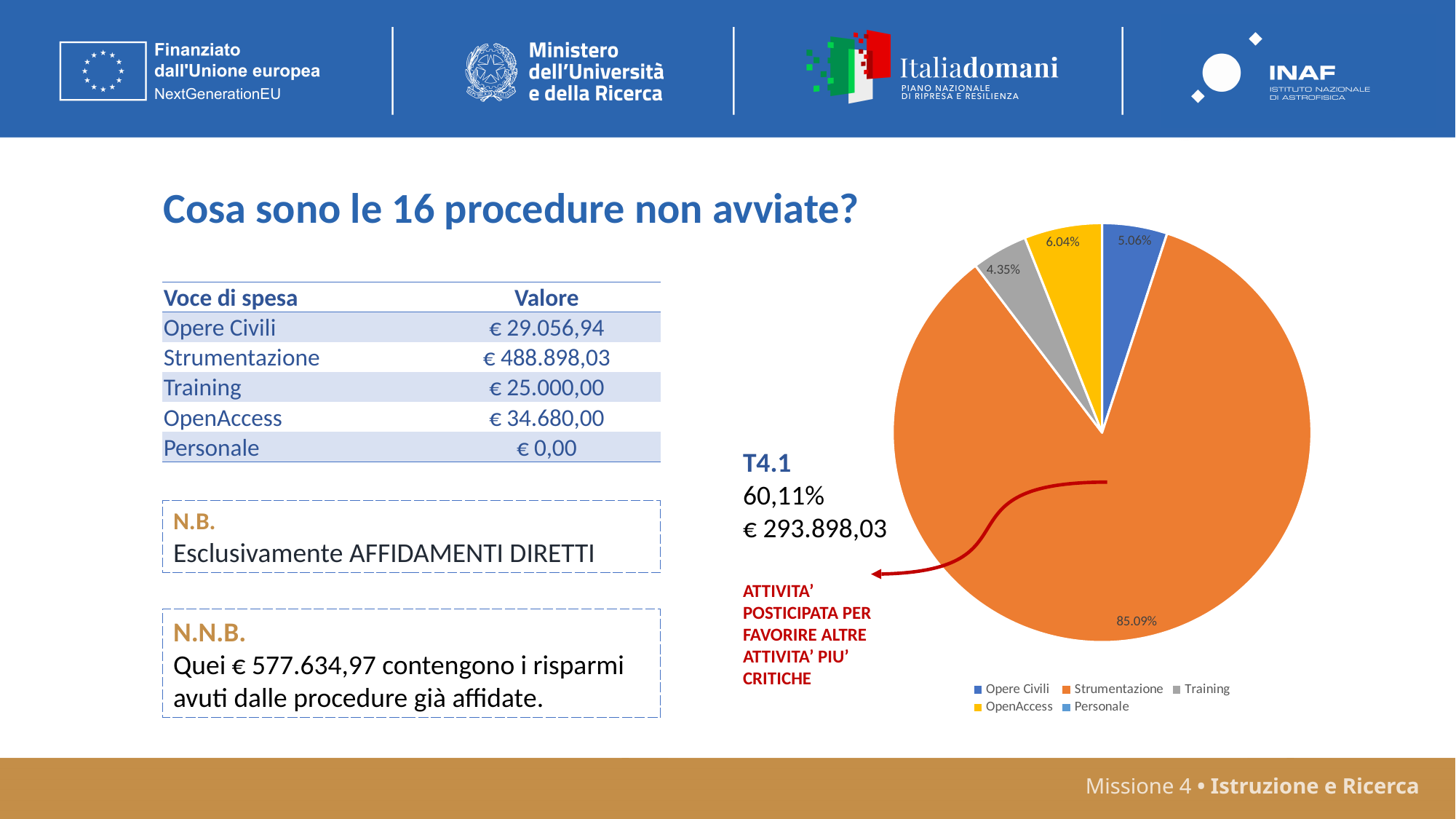
What share of the pie does Opere Civili take? 5.06% Which category has the largest slice of the pie chart? Strumentazione What share of the pie does Training take? 4.35% What colour is the Strumentazione slice in the pie chart? orange How many series does the pie chart's legend list? 5 What kind of chart is shown on the slide? pie chart What share of the pie does Strumentazione take? 85.09% Among the slices with printed labels, which category has the smallest share? Training Which slice is larger, OpenAccess or Opere Civili? OpenAccess What is the difference in percentage points between the OpenAccess and Training slices? 1.69 Which legend entry is shown in yellow? OpenAccess